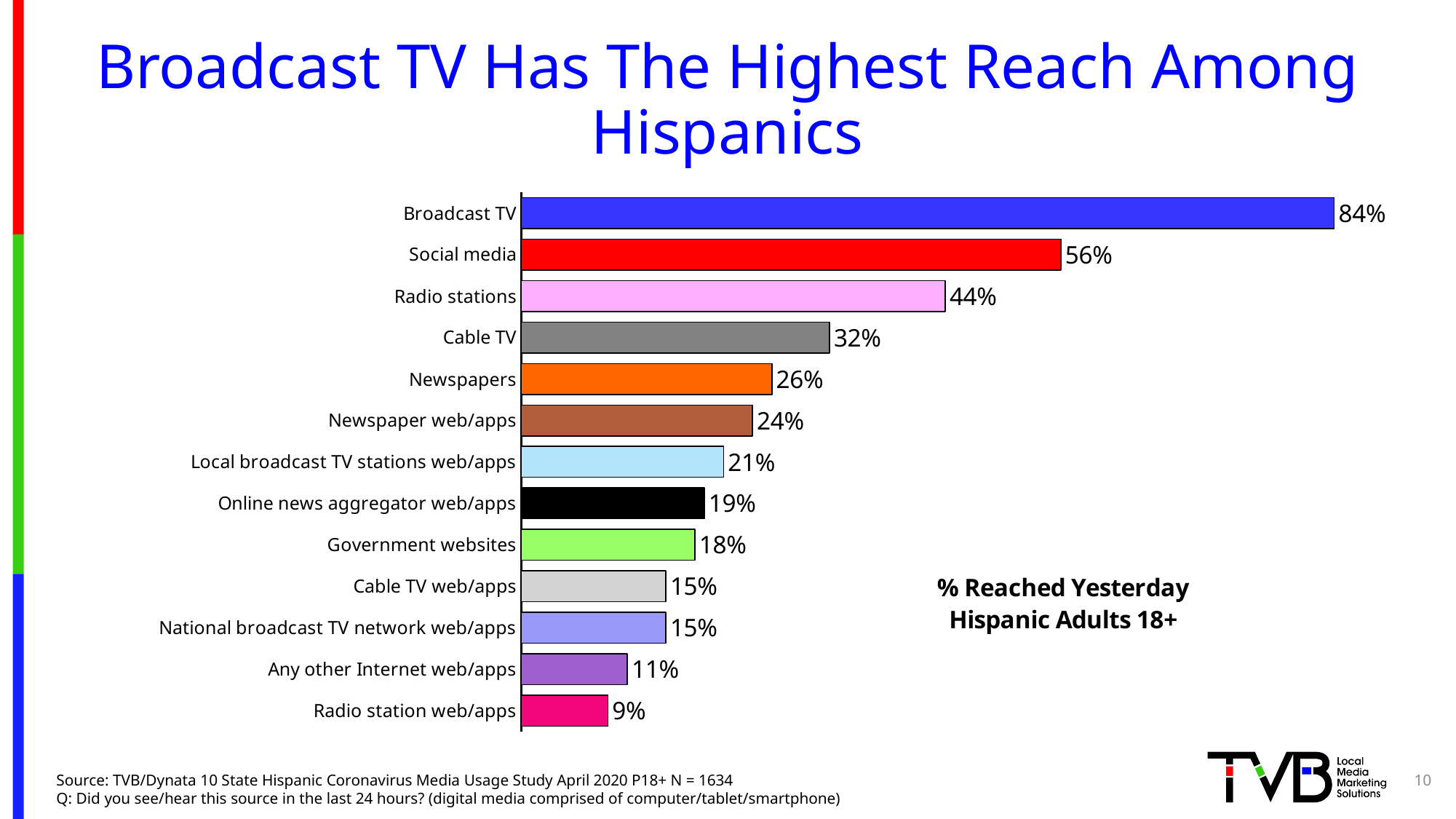
What is the difference between the values for Cable TV and Newspapers? 6% Which category has the highest value? Broadcast TV What colour is the bar for Social media? red What kind of chart is shown on the slide? bar chart What is the value for Radio stations? 44% What is the value for Broadcast TV? 84% Which is larger, the value for Newspaper web/apps or the value for Local broadcast TV stations web/apps? Newspaper web/apps What is the value for Any other Internet web/apps? 11% How many categories are shown in the chart? 13 What is the difference between the values for Broadcast TV and Social media? 28% Which category has the lowest value? Radio station web/apps What is the value for Government websites? 18%